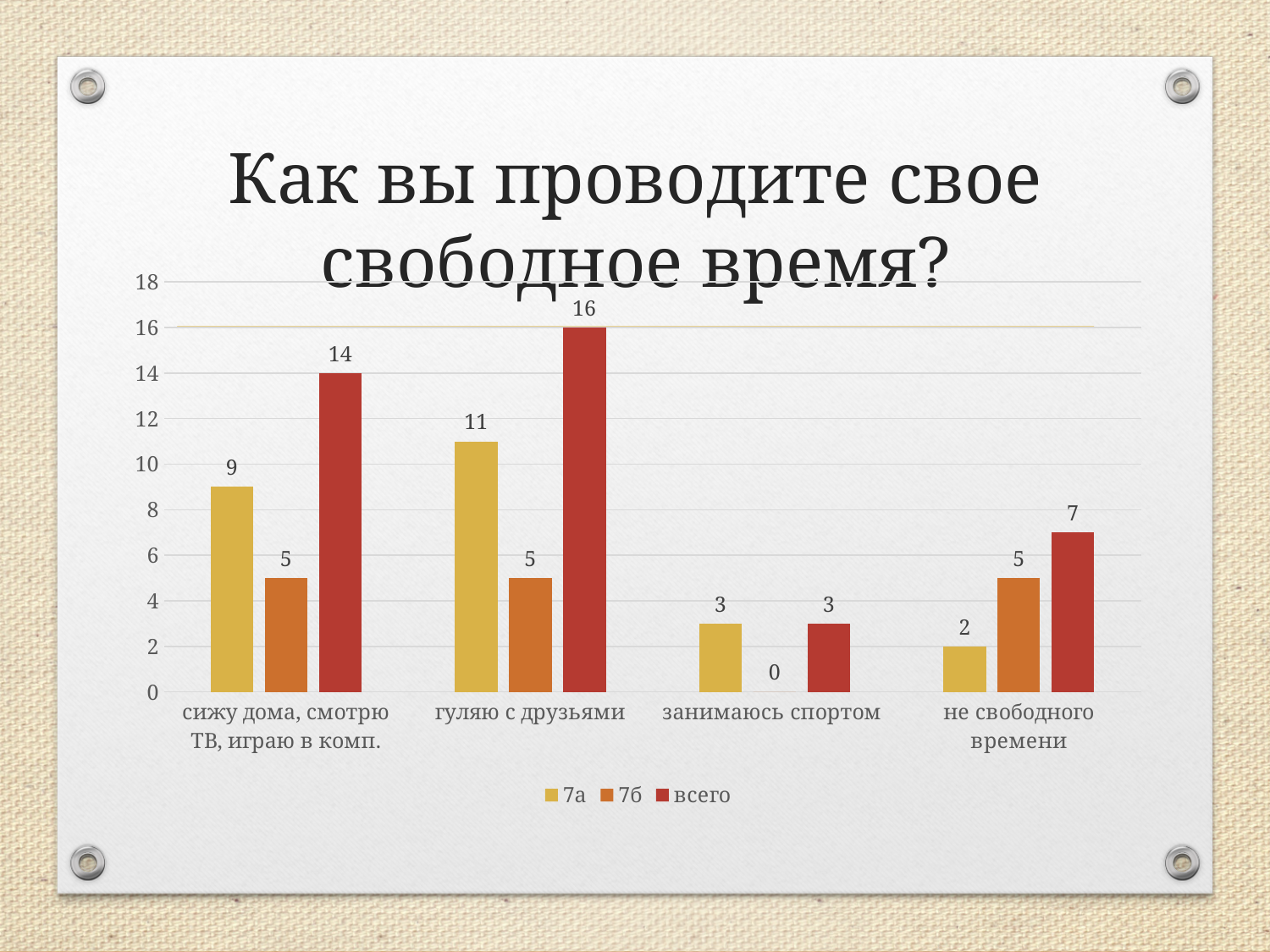
What is the value for 7а in the category "гуляю с друзьями"? 11 What is the value for всего in the category "сижу дома, смотрю ТВ, играю в комп."? 14 Which category has the highest value for всего? гуляю с друзьями What kind of chart is shown on the slide? bar chart What is the value for 7а in the category "не свободного времени"? 2 Which category has the lowest value for 7а? не свободного времени How many categories are shown on the x axis? 4 What is the value for 7б in the category "занимаюсь спортом"? 0 What is the title of the chart? Как вы проводите свое свободное время? What is the difference between the всего values for "гуляю с друзьями" and "сижу дома, смотрю ТВ, играю в комп."? 2 How many series does the legend list? 3 Which is larger: the 7а value for "сижу дома, смотрю ТВ, играю в комп." or the 7б value for the same category? 7а